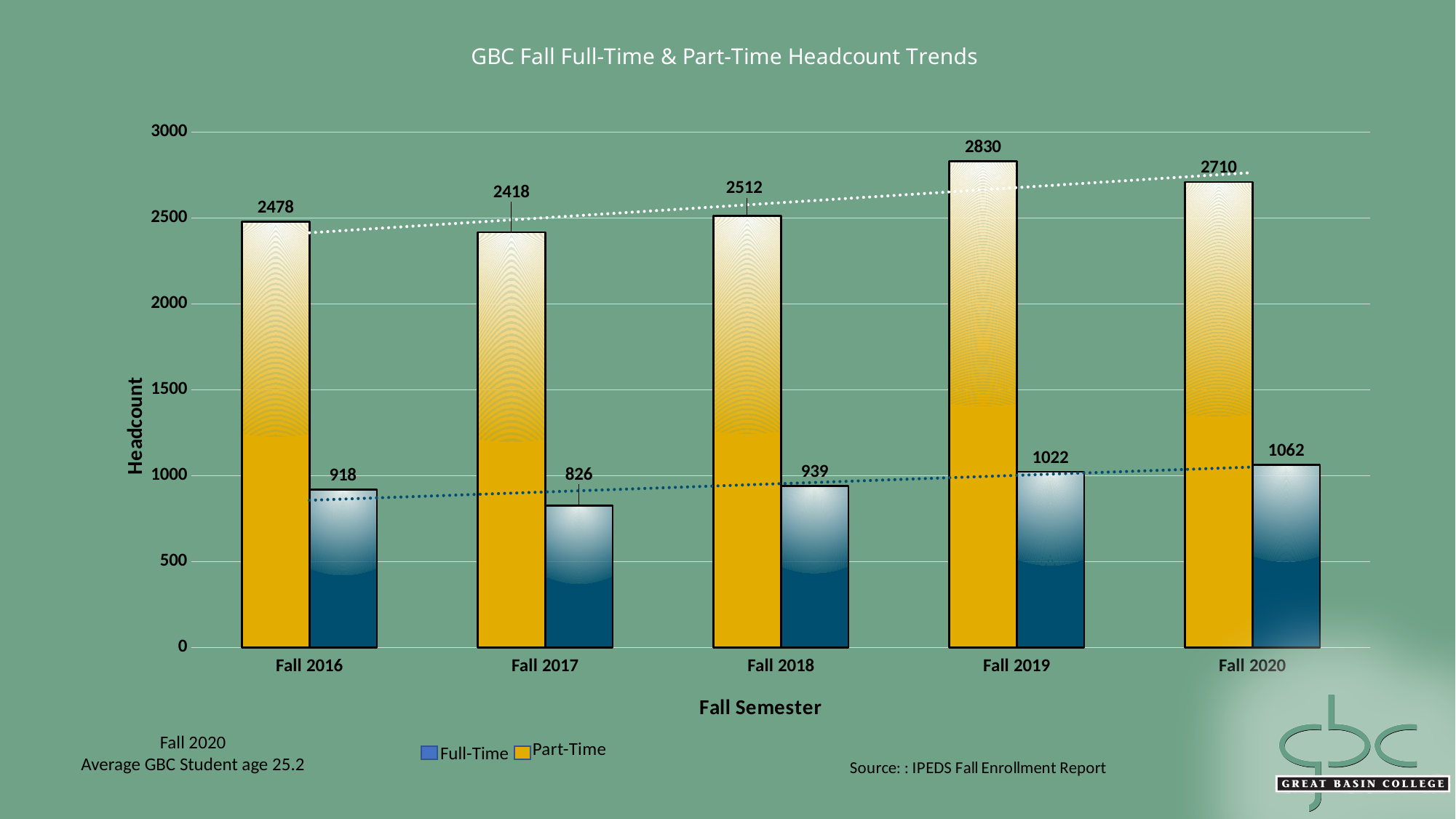
What is the Full-Time headcount for Fall 2020? 1062 What kind of chart is shown on the slide? bar chart By how much did the Full-Time headcount change from Fall 2019 to Fall 2020? 40 Which fall semester has the highest Part-Time headcount? Fall 2019 Which fall semester has the lowest Full-Time headcount? Fall 2017 What is the Part-Time headcount for Fall 2019? 2830 Which is larger, the Part-Time headcount in Fall 2018 or in Fall 2020? Fall 2020 What is the difference between the Part-Time and Full-Time headcounts in Fall 2016? 1560 Is the Full-Time headcount for Fall 2018 greater or less than 1000? less What is the Full-Time headcount for Fall 2017? 826 How many fall semesters are shown on the x axis? 5 How many series does the legend list? 2